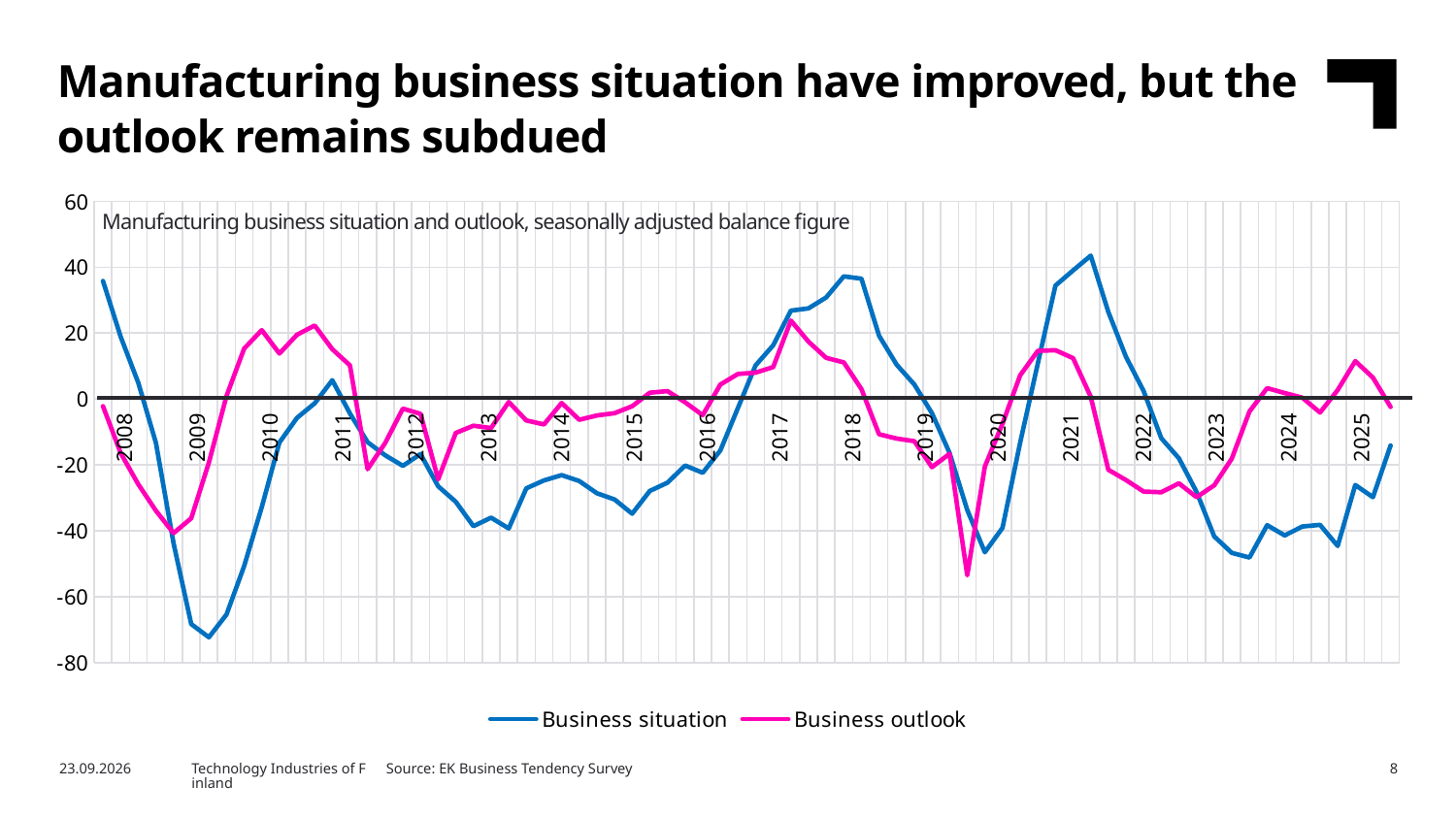
How many year labels are shown on the x axis? 18 Is the peak of the Business outlook line around 2017 greater or less than 40? less What kind of chart is shown on the slide? Line chart Is the lowest value of the Business outlook line, reached around 2020, greater or less than -40? less Which series reaches the lowest value anywhere on the chart? Business situation Which series reaches the highest value anywhere on the chart? Business situation What are the two series named in the legend? Business situation and Business outlook How many series does the legend list? 2 Is the lowest value of the Business situation line, reached around 2009, greater or less than -60? less Does the Business situation line rise or fall between 2021 and 2023? Fall What is the title printed inside the chart area? Manufacturing business situation and outlook, seasonally adjusted balance figure